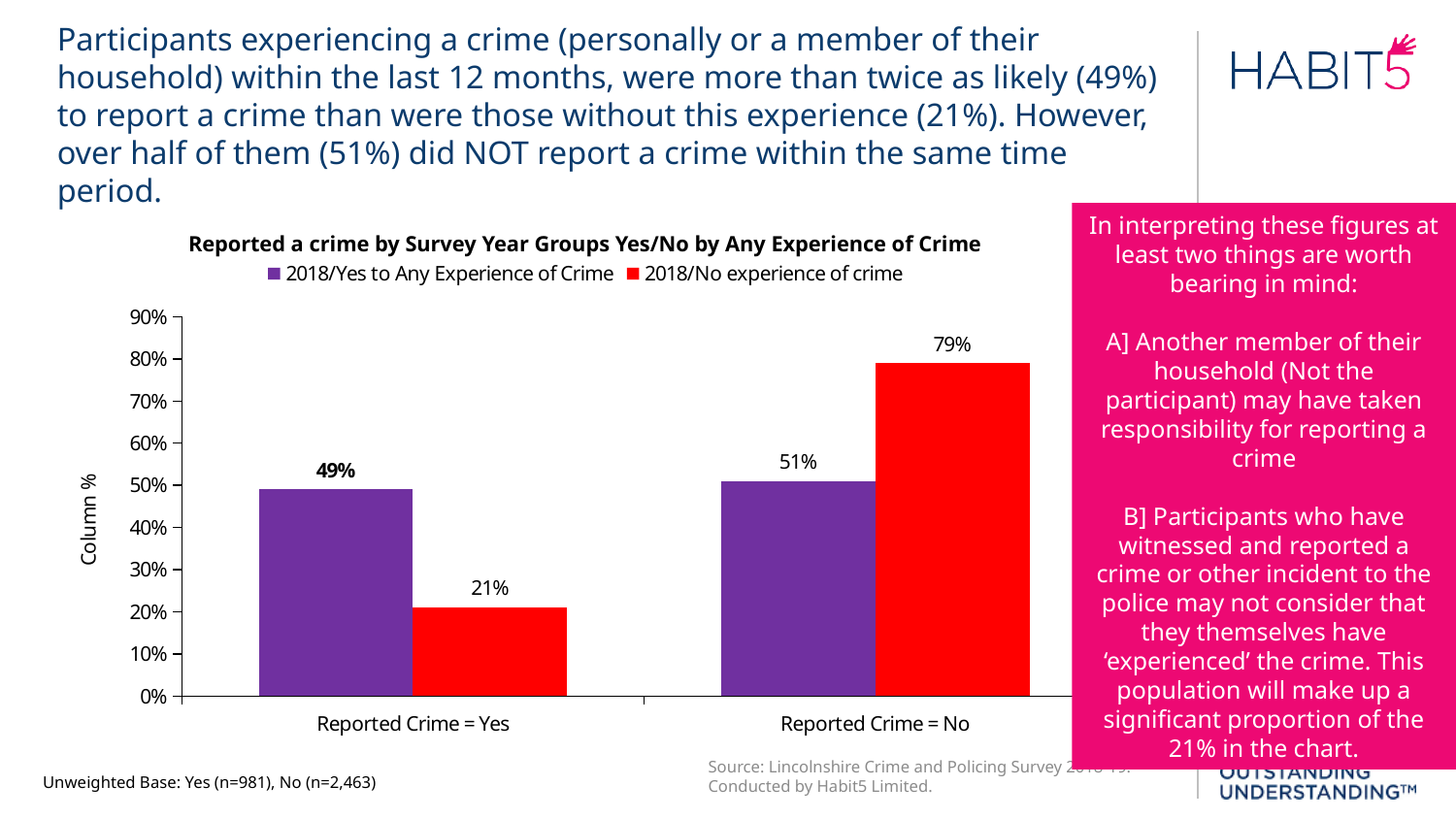
What is the value for '2018/No experience of crime' in the 'Reported Crime = No' category? 79% How many categories are shown on the x axis? 2 What is the value for '2018/Yes to Any Experience of Crime' in the 'Reported Crime = No' category? 51% Which bar in the chart has the lowest value? 2018/No experience of crime, Reported Crime = Yes Which bar in the chart has the highest value? 2018/No experience of crime, Reported Crime = No How many series does the legend list? 2 What is the label of the y axis? Column % What is the difference between the two series in the 'Reported Crime = No' category? 28% In the 'Reported Crime = Yes' category, which series has the larger value? 2018/Yes to Any Experience of Crime What kind of chart is shown on the slide? Bar chart What is the value for '2018/Yes to Any Experience of Crime' in the 'Reported Crime = Yes' category? 49% What is the value for '2018/No experience of crime' in the 'Reported Crime = Yes' category? 21%